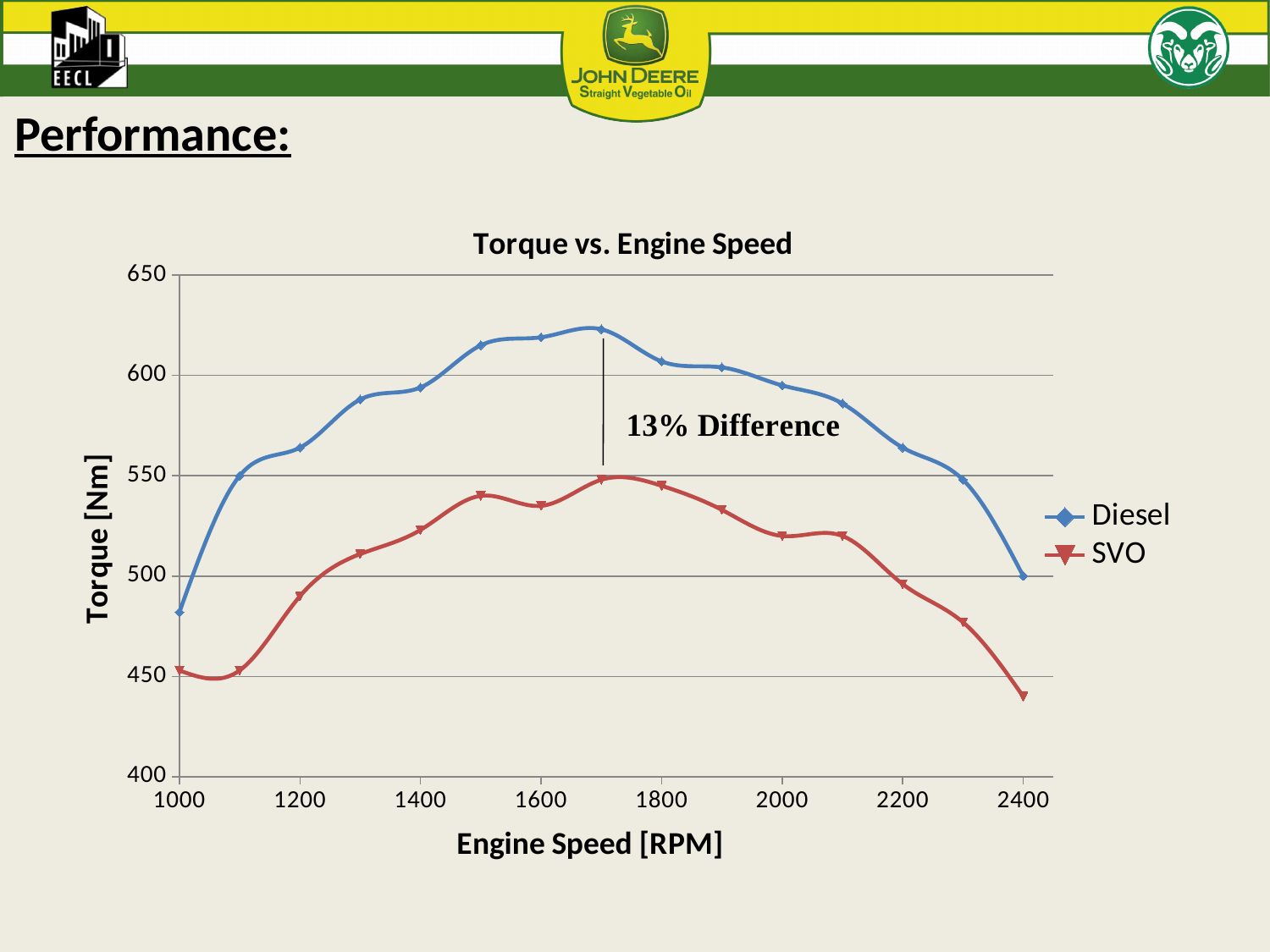
Is the Diesel torque at 1700 RPM greater or less than 600? greater Does the SVO torque rise or fall between 2000 RPM and 2400 RPM? fall How many data points are plotted for the Diesel series? 15 Which series has the higher torque at 1600 RPM, Diesel or SVO? Diesel What are the two series named in the legend? Diesel and SVO At which engine speed does the Diesel series reach its highest torque? 1700 How many series does the legend list? 2 Is the SVO torque at 2400 RPM greater or less than 450? less What kind of chart is shown on the slide? line chart What is the title of the chart? Torque vs. Engine Speed At which engine speed does the SVO series reach its lowest torque? 2400 Is the Diesel torque at 1200 RPM greater or less than 550? greater